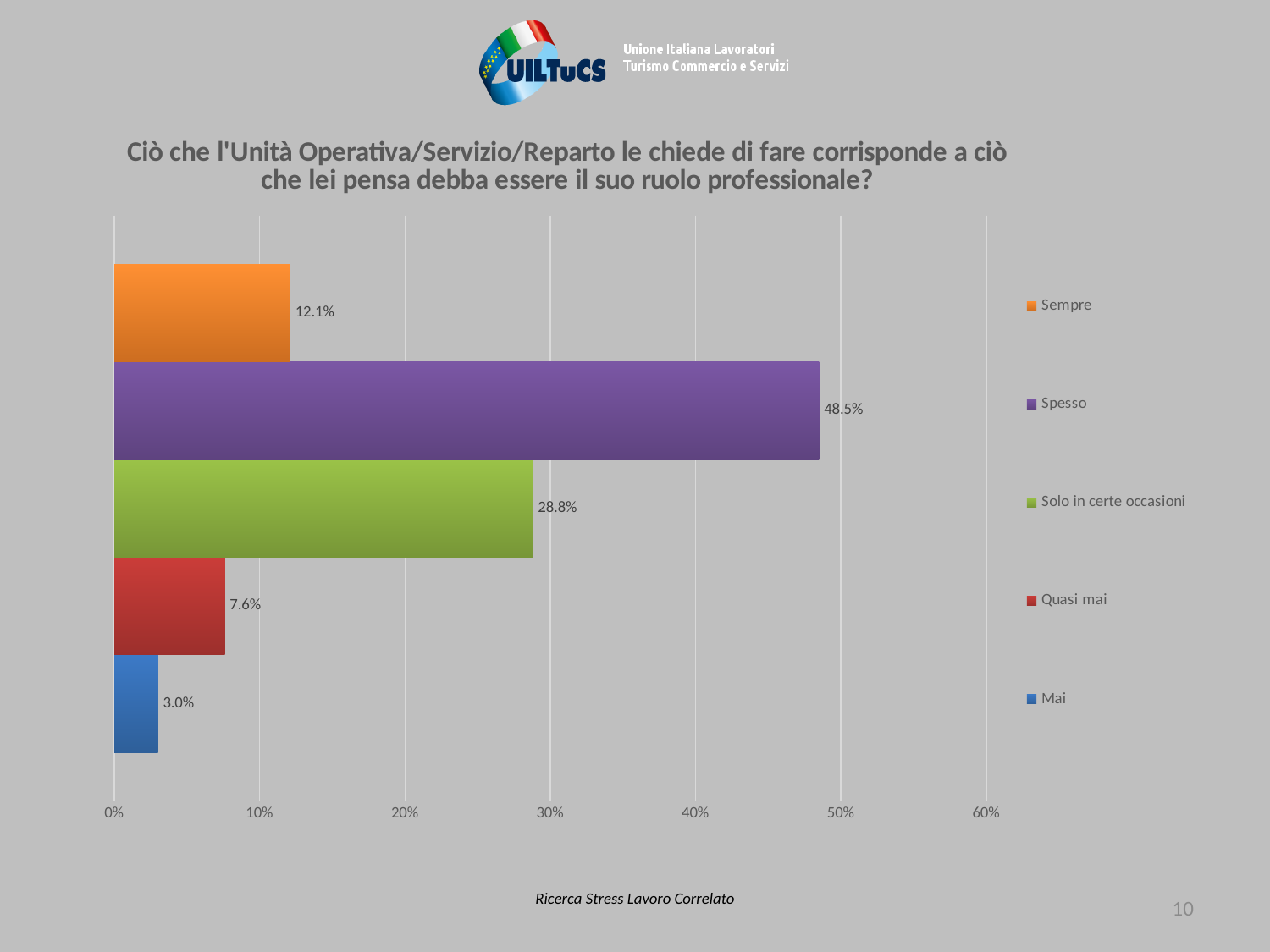
What colour is the bar for Quasi mai? red Which is larger, the value for Sempre or the value for Quasi mai? Sempre How many series does the legend list? 5 Is the value for Spesso greater or less than 40%? greater What is the value for Spesso? 48.5% What is the value for Mai? 3.0% Which category has the highest value? Spesso What is the value for Solo in certe occasioni? 28.8% Which category has the lowest value? Mai What is the value for Sempre? 12.1% What is the difference between the values for Spesso and Solo in certe occasioni? 19.7% What kind of chart is shown on the slide? bar chart